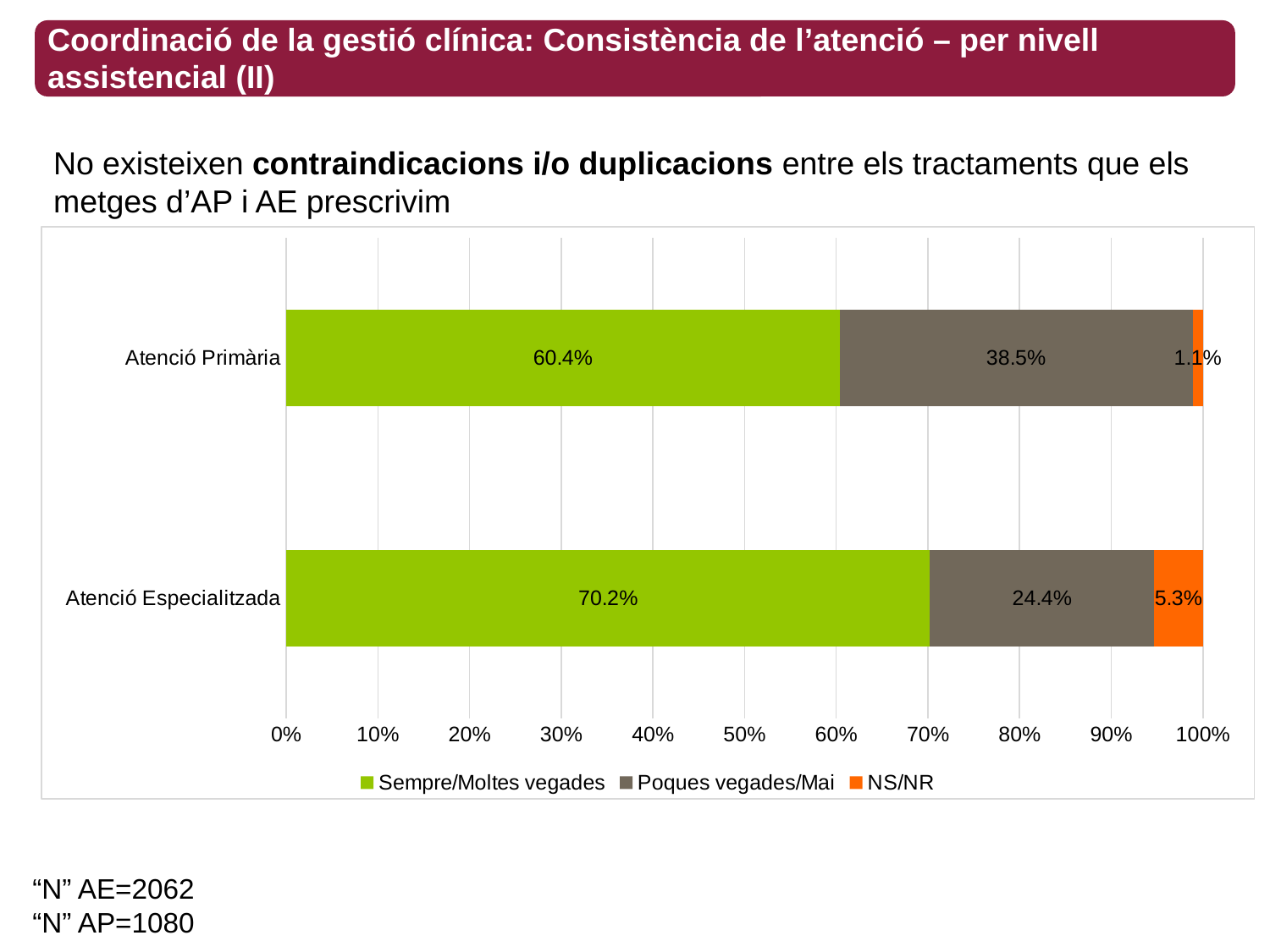
What is the difference between the Sempre/Moltes vegades values for Atenció Especialitzada and Atenció Primària? 9.8% Is the Poques vegades/Mai value larger for Atenció Primària or Atenció Especialitzada? Atenció Primària What kind of chart is shown? Stacked bar chart Which legend entry is shown in orange? NS/NR What is the NS/NR value for Atenció Primària? 1.1% What is the value of Sempre/Moltes vegades for Atenció Primària? 60.4% Which category has the lower Poques vegades/Mai value? Atenció Especialitzada How many series does the legend list? 3 What is the NS/NR value for Atenció Especialitzada? 5.3% What is the value of Poques vegades/Mai for Atenció Especialitzada? 24.4% Which category has the higher Sempre/Moltes vegades value? Atenció Especialitzada How many categories are shown on the y axis? 2